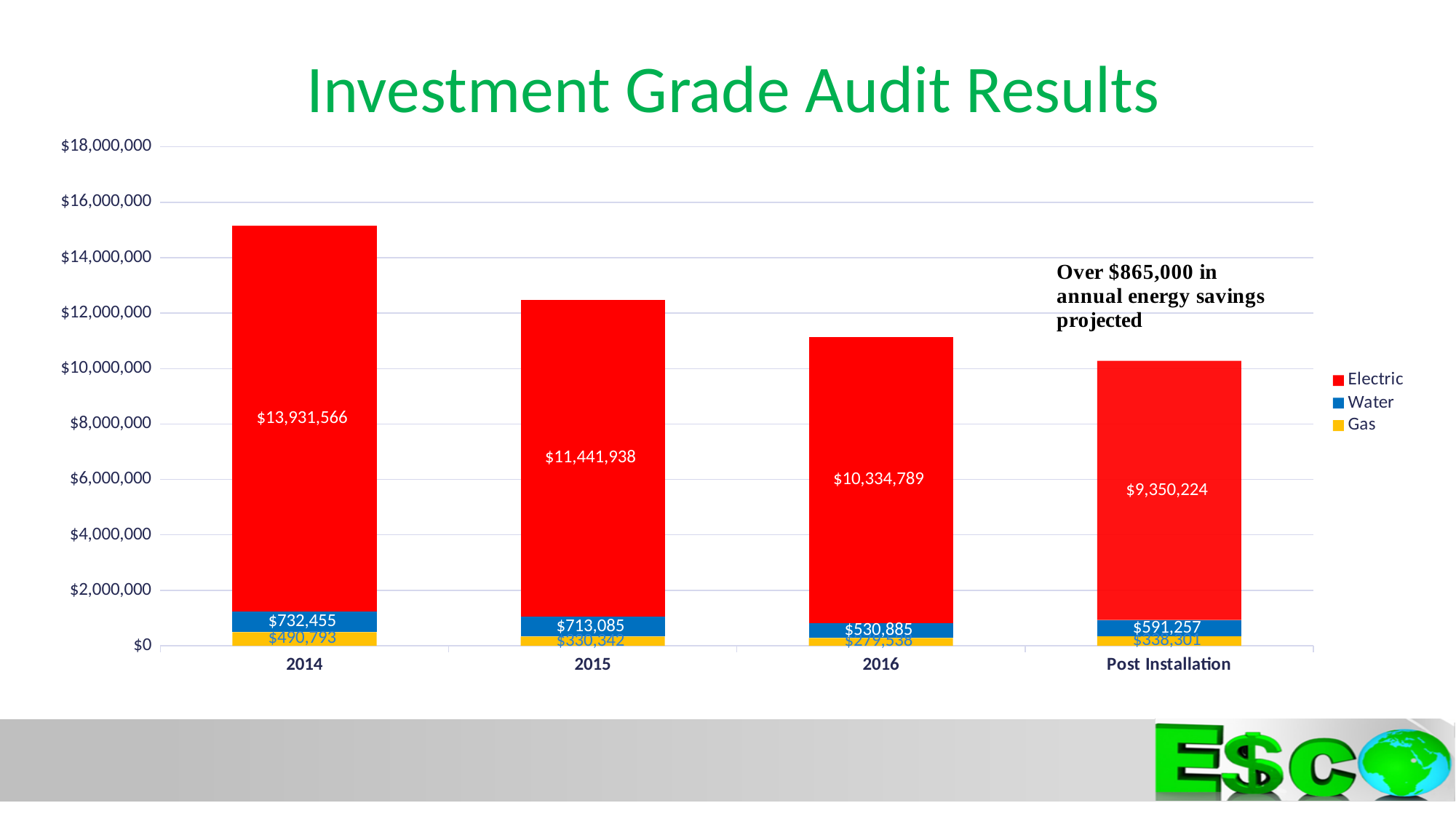
What is the Electric value for Post Installation? $9,350,224 What is the Water value for 2015? $713,085 What is the difference between the Electric values for 2014 and 2015? $2,489,628 Which category has the lowest Electric value? Post Installation What is the Water value for 2016? $530,885 What kind of chart is shown on the slide? Stacked bar chart How many series does the legend list? 3 Which is larger, the Water value for 2016 or the Water value for Post Installation? Post Installation What is the Electric value for 2014? $13,931,566 Do the Electric values rise or fall from 2014 to Post Installation? Fall Is the total stacked bar for 2014 greater or less than $14,000,000? greater Which category has the highest Electric value? 2014